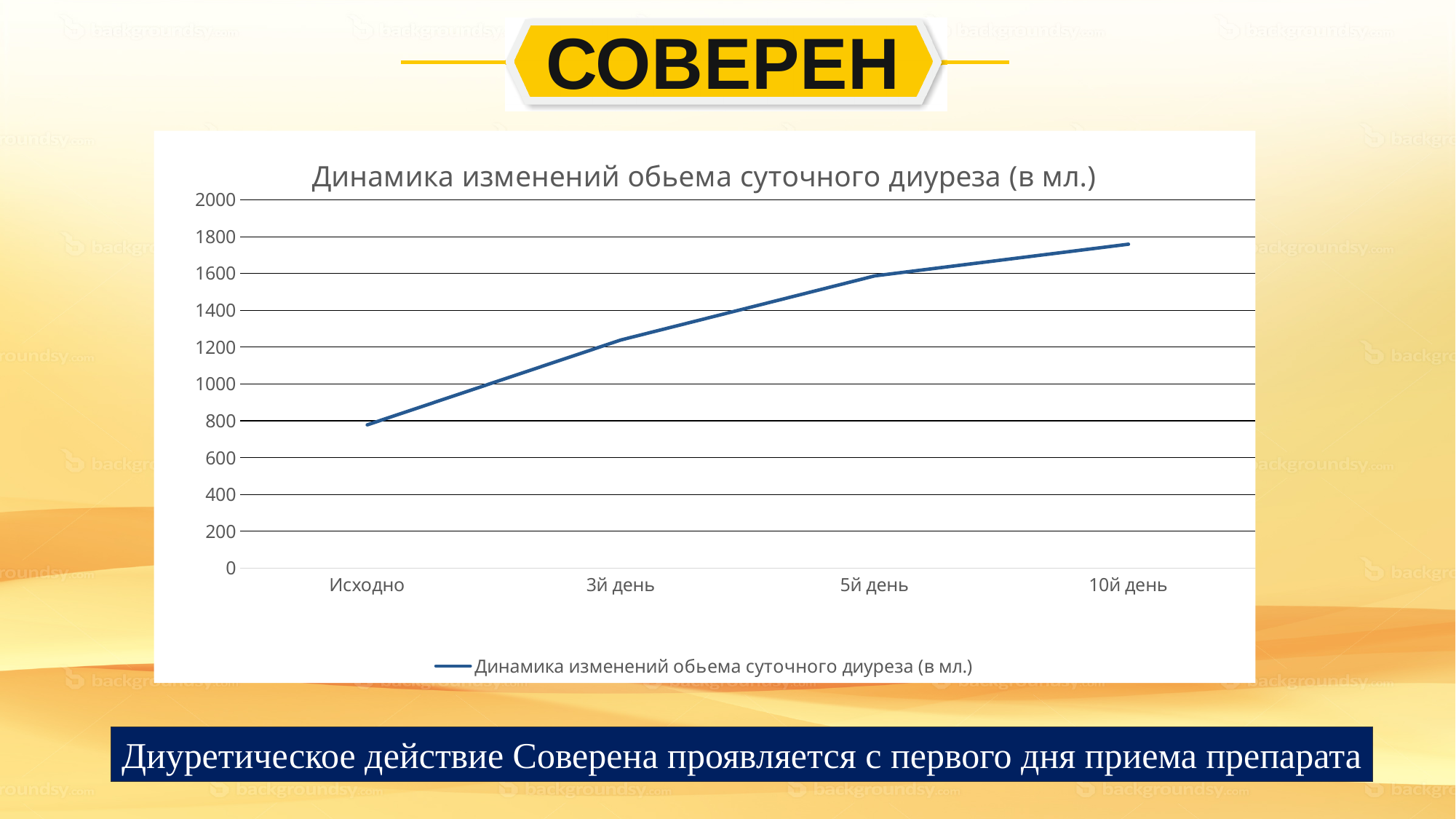
Which category has the lowest value? Исходно Which is larger, the value for 3й день or the value for 5й день? 5й день Is the value for Исходно greater or less than 1000? less Do the values rise or fall from Исходно to 10й день? rise Is the value for 10й день greater or less than 1800? less Is the value for 5й день greater or less than 1400? greater Which category has the highest value? 10й день How many series does the legend list? 1 What kind of chart is shown on the slide? line chart What is the title of the chart? Динамика изменений обьема суточного диуреза (в мл.) How many points are plotted on the line? 4